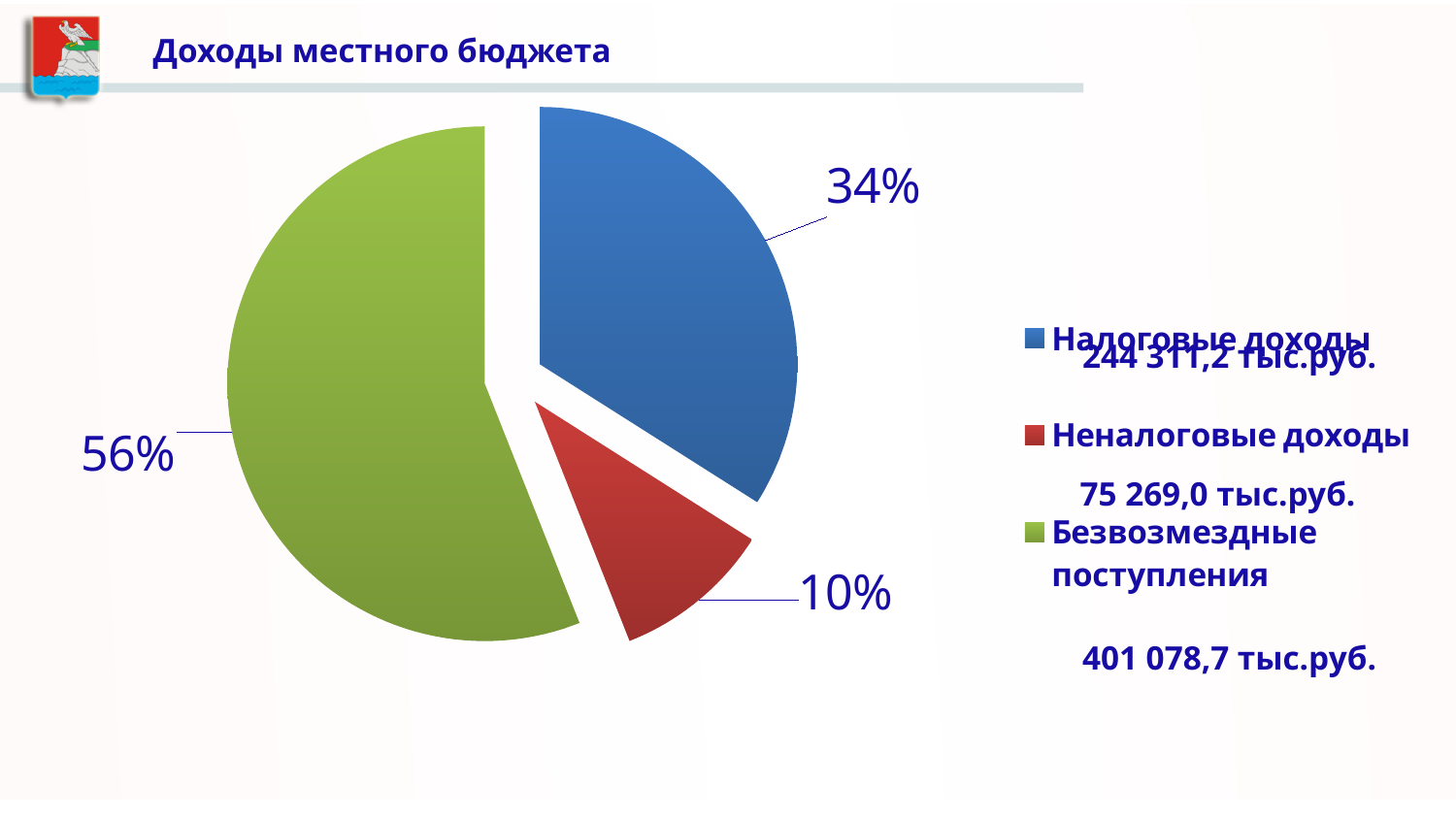
Which category has the largest slice of the pie? Безвозмездные поступления What is the difference in percentage points between the Безвозмездные поступления slice and the Налоговые доходы slice? 22 What is the title of the slide containing the pie chart? Доходы местного бюджета What kind of chart is shown on the slide? pie chart What colour is the Безвозмездные поступления slice? green What share of the pie does Неналоговые доходы have? 10% Which category has the smallest slice of the pie? Неналоговые доходы How many slices does the pie chart have? 3 How many entries does the legend list? 3 What share of the pie does Налоговые доходы have? 34% What share of the pie does Безвозмездные поступления have? 56% Which slice is larger, Налоговые доходы or Неналоговые доходы? Налоговые доходы